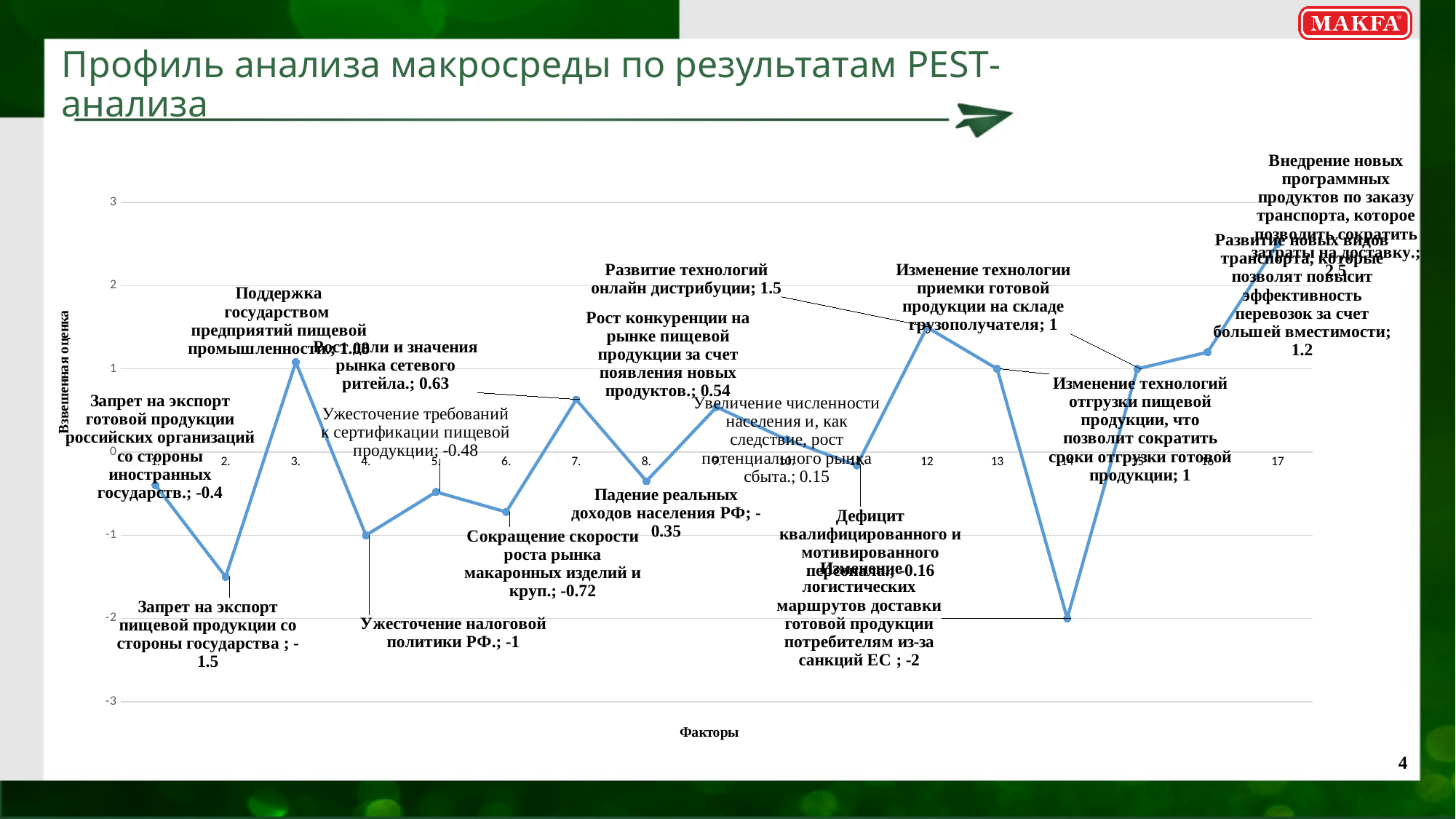
What kind of chart is shown on the slide? line chart Is the value for "Запрет на экспорт пищевой продукции со стороны государства" greater or less than -1? less What is the title of the vertical axis of the chart? Взвешенная оценка What is the weighted score for "Развитие новых видов транспорта, которые позволят повысить эффективность перевозок за счет большей вместимости"? 1.2 What is the weighted score for "Запрет на экспорт пищевой продукции со стороны государства"? -1.5 Which has the larger weighted score: "Развитие технологий онлайн дистрибуции" or "Развитие новых видов транспорта"? Развитие технологий онлайн дистрибуции What is the weighted score for "Развитие технологий онлайн дистрибуции"? 1.5 What is the weighted score for "Ужесточение налоговой политики РФ"? -1 Which factor has the highest weighted score? Внедрение новых программных продуктов по заказу транспорта, которое позволить сократить затраты на доставку (2.5) What is the weighted score for "Сокращение скорости роста рынка макаронных изделий и круп"? -0.72 What is the difference between the highest score (2.5) and the lowest score (-2)? 4.5 Which factor has the lowest weighted score? Изменение логистических маршрутов доставки готовой продукции потребителям из-за санкций ЕС (-2)